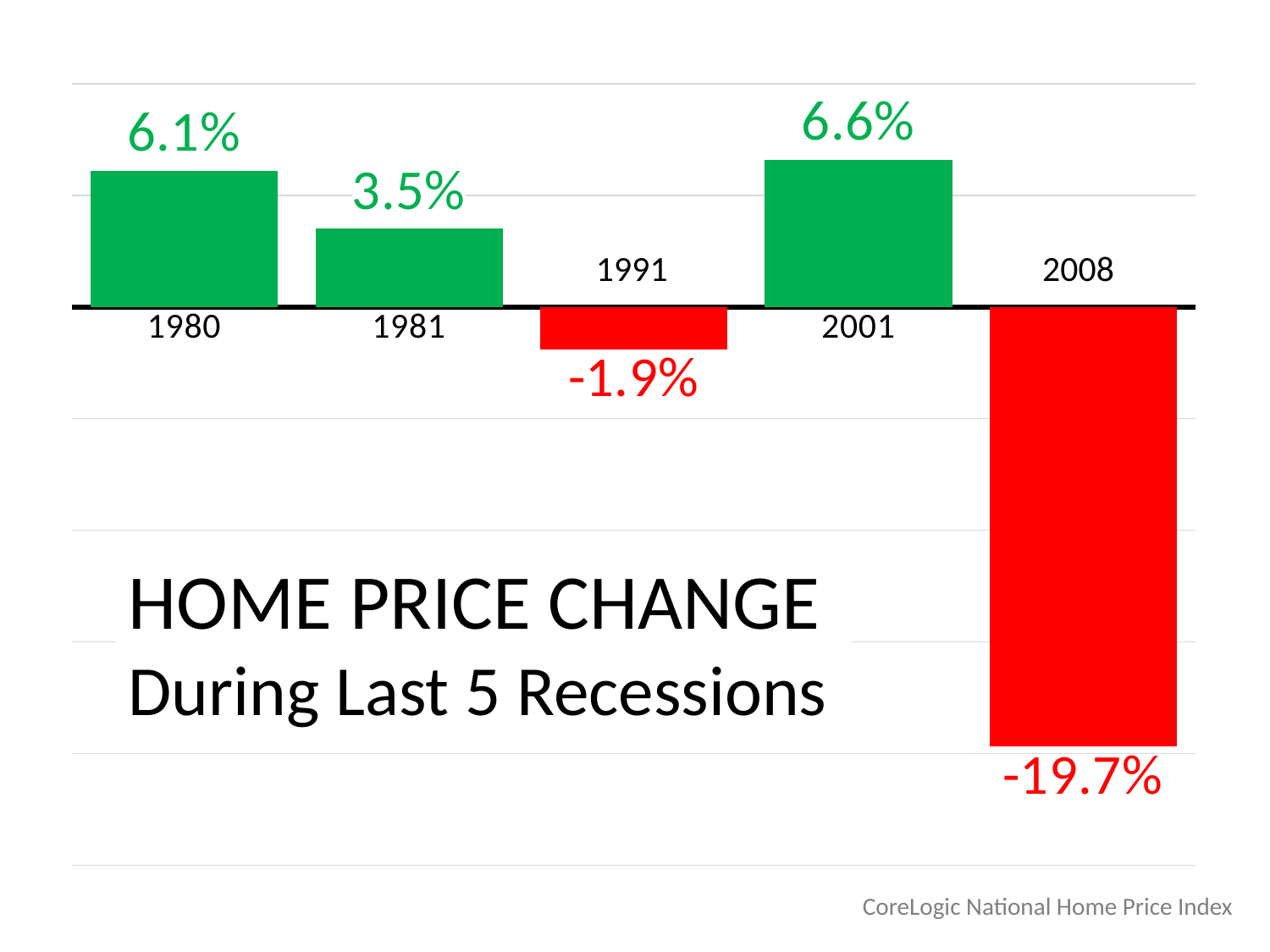
Which recession year shows the highest home price change? 2001 Which recession year shows the lowest home price change? 2008 What was the home price change during the 2008 recession? -19.7% What is the title of the chart? HOME PRICE CHANGE During Last 5 Recessions What was the home price change during the 1980 recession? 6.1% What was the home price change during the 1991 recession? -1.9% What colour are the bars for recessions with negative home price change? Red How many recessions are shown in the chart? 5 What is the difference between the home price change in 2001 and in 1981? 3.1 percentage points Which recession had a larger home price change, 1980 or 1981? 1980 How many of the recessions shown had a negative home price change? 2 What type of chart is shown on the slide? Bar chart